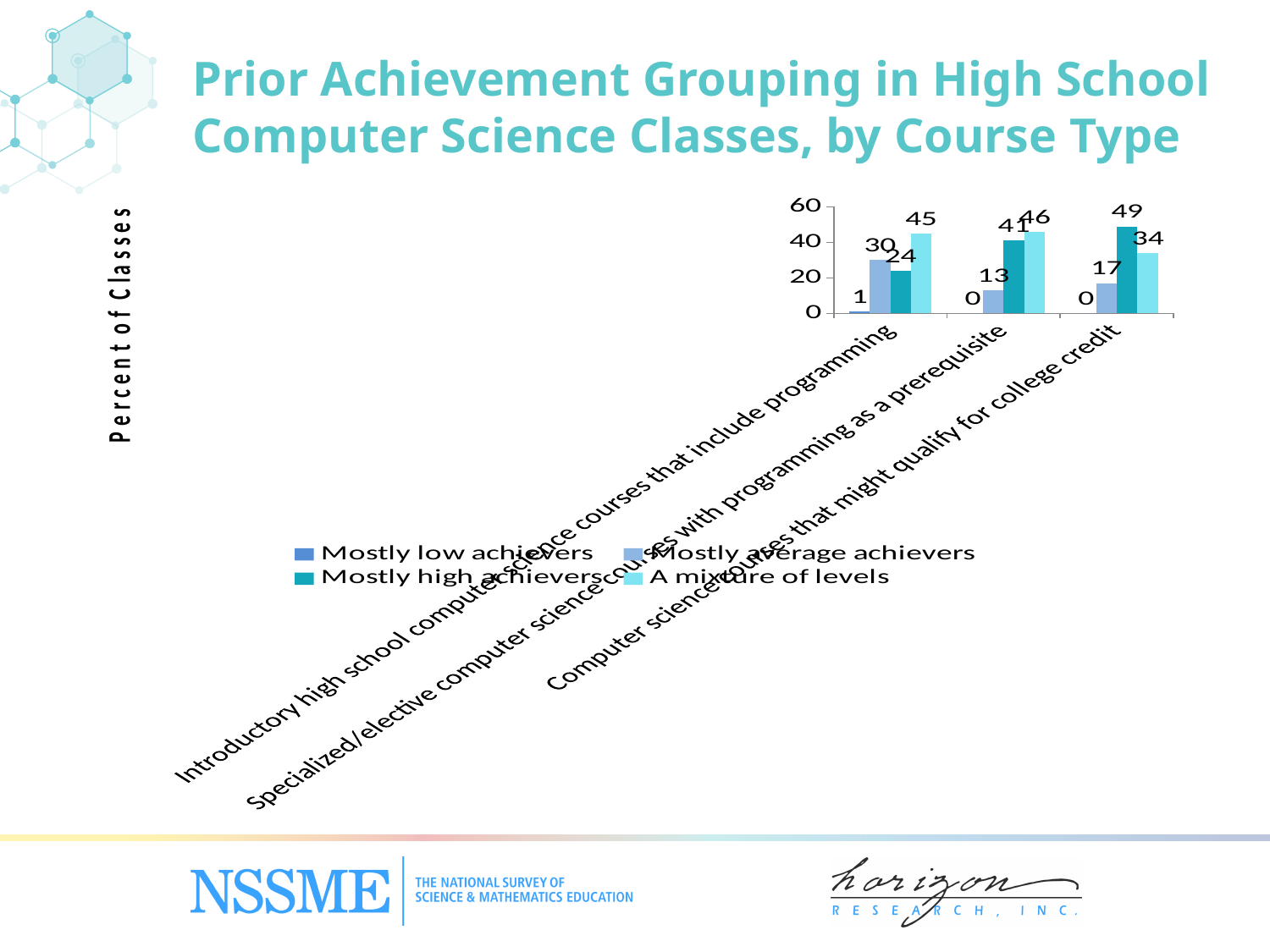
What kind of chart is shown on the slide? Bar chart What percent of computer science courses that might qualify for college credit are mostly high achievers? 49 What percent of specialized/elective computer science courses with programming as a prerequisite are mostly average achievers? 13 What percent of introductory high school computer science courses that include programming are mostly low achievers? 1 What is the label on the vertical axis? Percent of Classes For introductory high school computer science courses that include programming, which is larger: mostly average achievers or mostly high achievers? Mostly average achievers What percent of introductory high school computer science courses that include programming are a mixture of levels? 45 Which course type has the highest percent of classes that are mostly high achievers? Computer science courses that might qualify for college credit Which course type has the lowest percent of classes that are a mixture of levels? Computer science courses that might qualify for college credit How many series does the legend list? 4 How many course types are shown on the x axis? 3 What is the difference between the percent of specialized/elective courses that are mostly high achievers and the percent that are mostly average achievers? 28